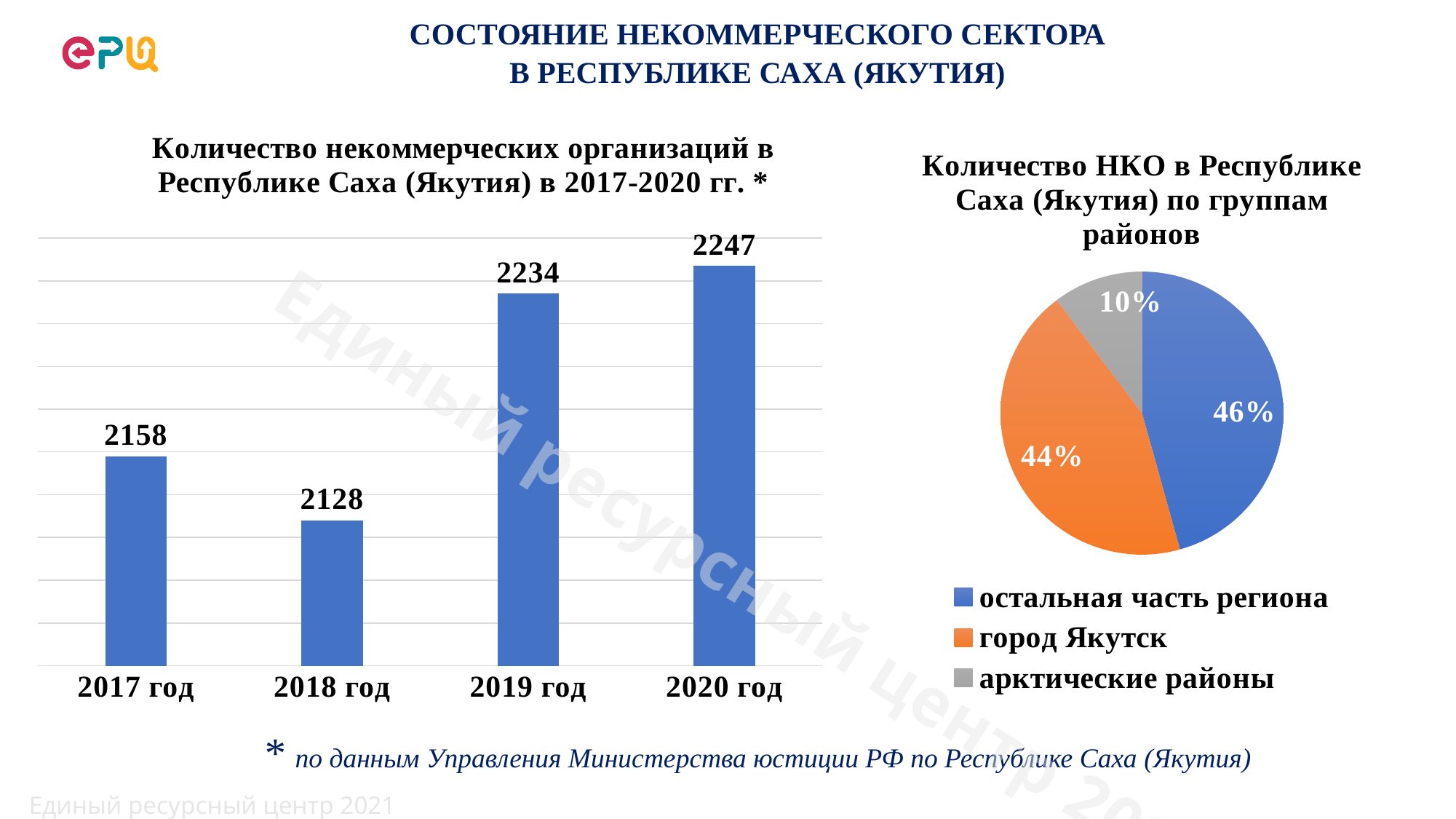
What kind of chart is the chart on the left? bar chart In the pie chart on the right, what share does город Якутск have? 44% In the bar chart on the left, which is larger: the value for 2017 год or 2018 год? 2017 год In the pie chart on the right, what share does арктические районы have? 10% In the bar chart on the left, which year has the lowest value? 2018 год In the bar chart on the left, what is the value for 2020 год? 2247 How many entries does the legend of the pie chart on the right list? 3 In the pie chart on the right, which group has the largest share? остальная часть региона In the bar chart on the left, which year has the highest value? 2020 год How many bars are in the bar chart on the left? 4 In the bar chart on the left, what is the value for 2018 год? 2128 In the bar chart on the left, what is the difference between the values for 2019 год and 2017 год? 76